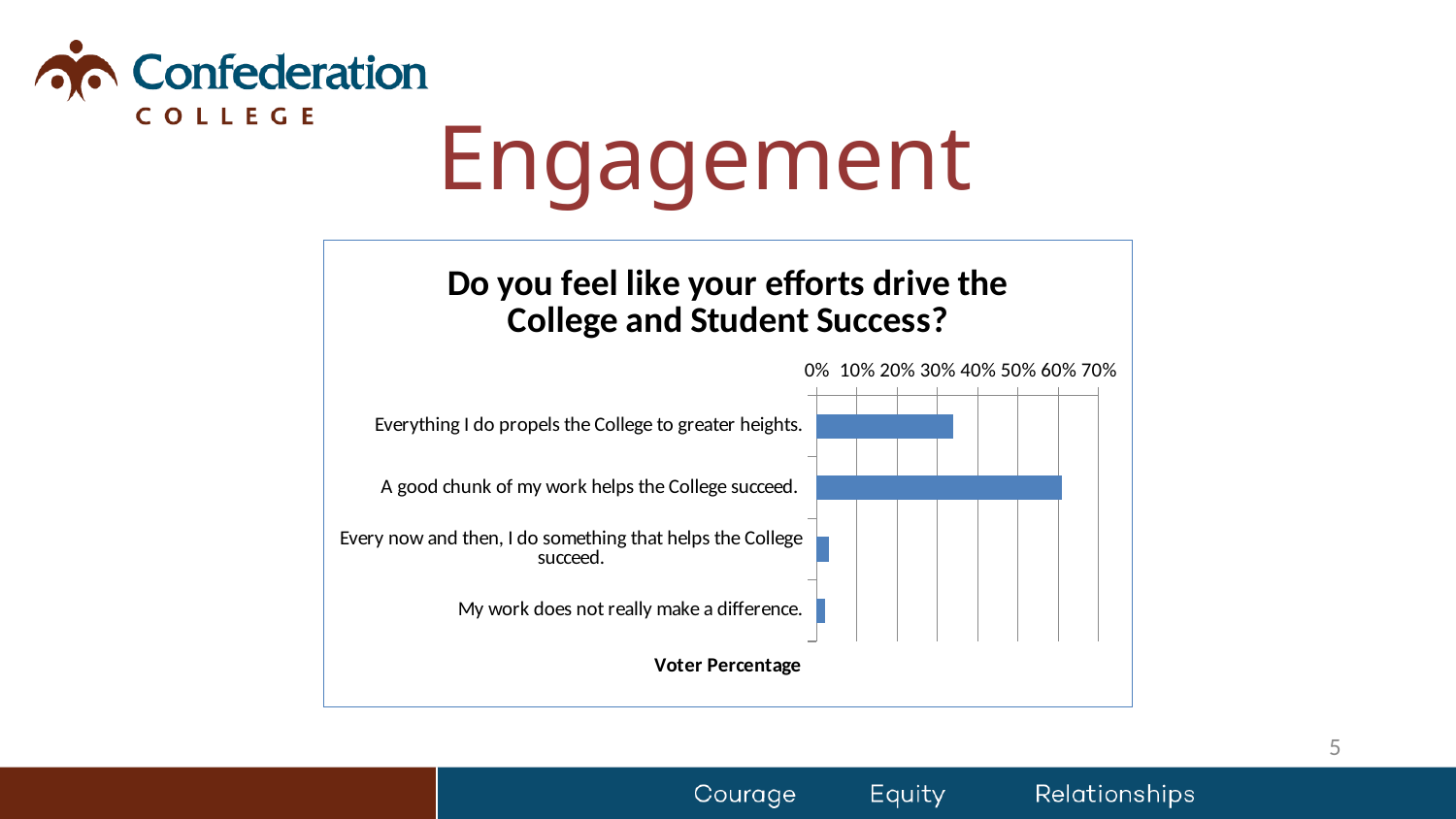
Which is larger: the value for "Everything I do propels the College to greater heights." or the value for "A good chunk of my work helps the College succeed."? A good chunk of my work helps the College succeed. Which response category has the highest voter percentage? A good chunk of my work helps the College succeed. Is the value for "My work does not really make a difference." greater or less than 10%? less Is the value for "Everything I do propels the College to greater heights." greater or less than 40%? less What is the title of the chart? Do you feel like your efforts drive the College and Student Success? How many response categories are plotted in the chart? 4 Is the value for "A good chunk of my work helps the College succeed." greater or less than 50%? greater What kind of chart is shown on the slide? bar chart What is the label on the value axis of the chart? Voter Percentage